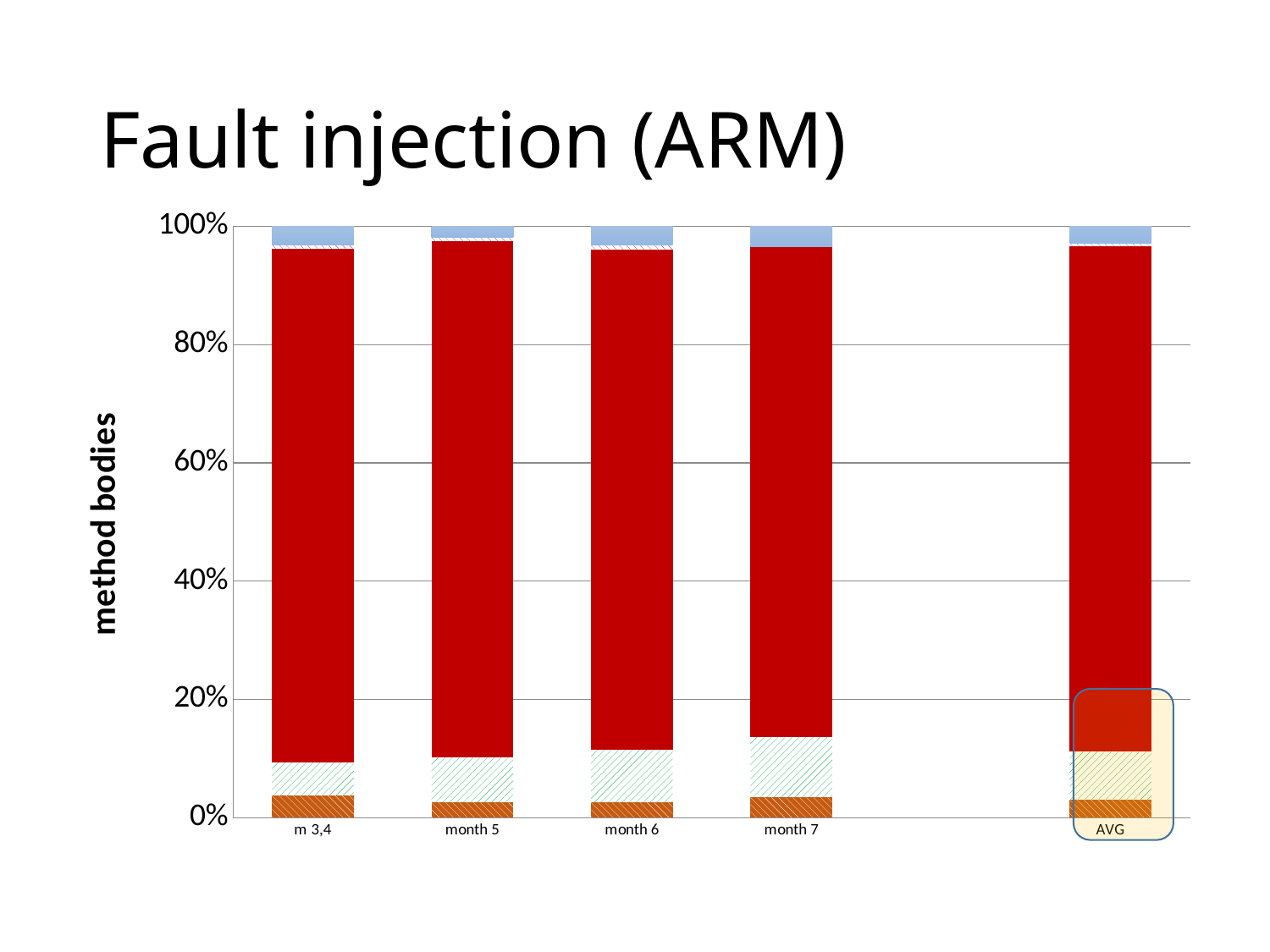
What is the label on the y axis of the chart? method bodies What is the total height of the stacked bar for AVG? 100% What kind of chart is shown on the slide? stacked bar chart Is the top of the green hatched segment in the month 6 bar greater or less than 20%? less Is the top of the green hatched segment in the month 7 bar greater or less than 40%? less What is the title of the slide containing the chart? Fault injection (ARM) What is the total height of the stacked bar for month 5? 100% How many categories are shown on the x axis of the chart? 5 Is the top of the red segment in the AVG bar greater or less than 60%? greater Which category label is the rightmost on the x axis? AVG